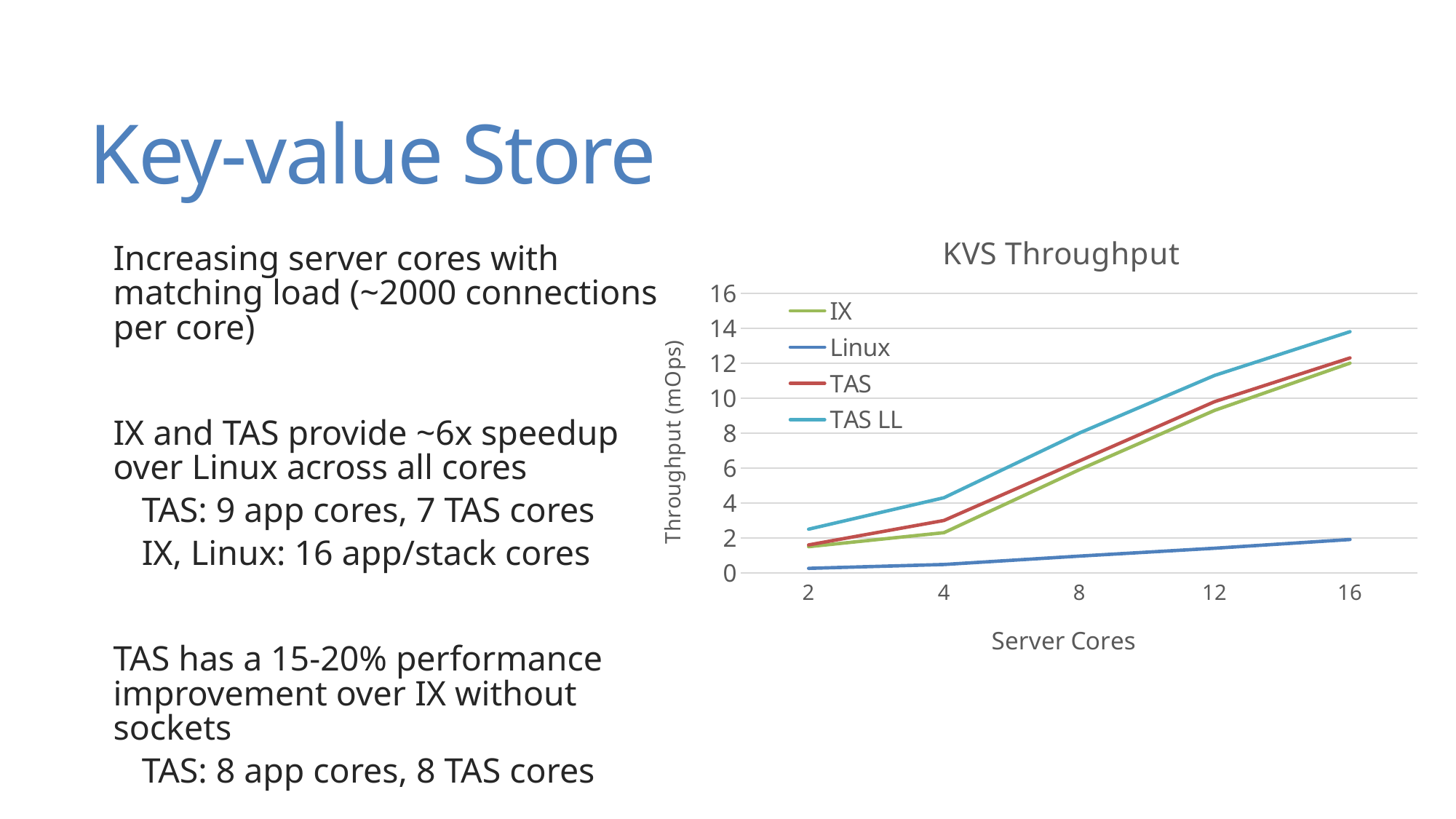
What is the title of the chart? KVS Throughput What kind of chart is shown on the slide? line chart Which series has the highest throughput at 16 server cores? TAS LL How many series does the legend of the KVS Throughput chart list? 4 At 8 server cores, which has higher throughput, TAS LL or Linux? TAS LL Is the throughput for Linux at 16 server cores greater or less than 4? less How many server core values are shown on the x axis of the KVS Throughput chart? 5 What is the label of the y axis of the chart? Throughput (mOps) Which series has the lowest throughput across all server core counts? Linux Is the throughput for TAS at 8 server cores greater or less than 4? greater Does the throughput for TAS LL rise or fall as the number of server cores increases? rise Is the throughput for TAS LL at 16 server cores greater or less than 12? greater